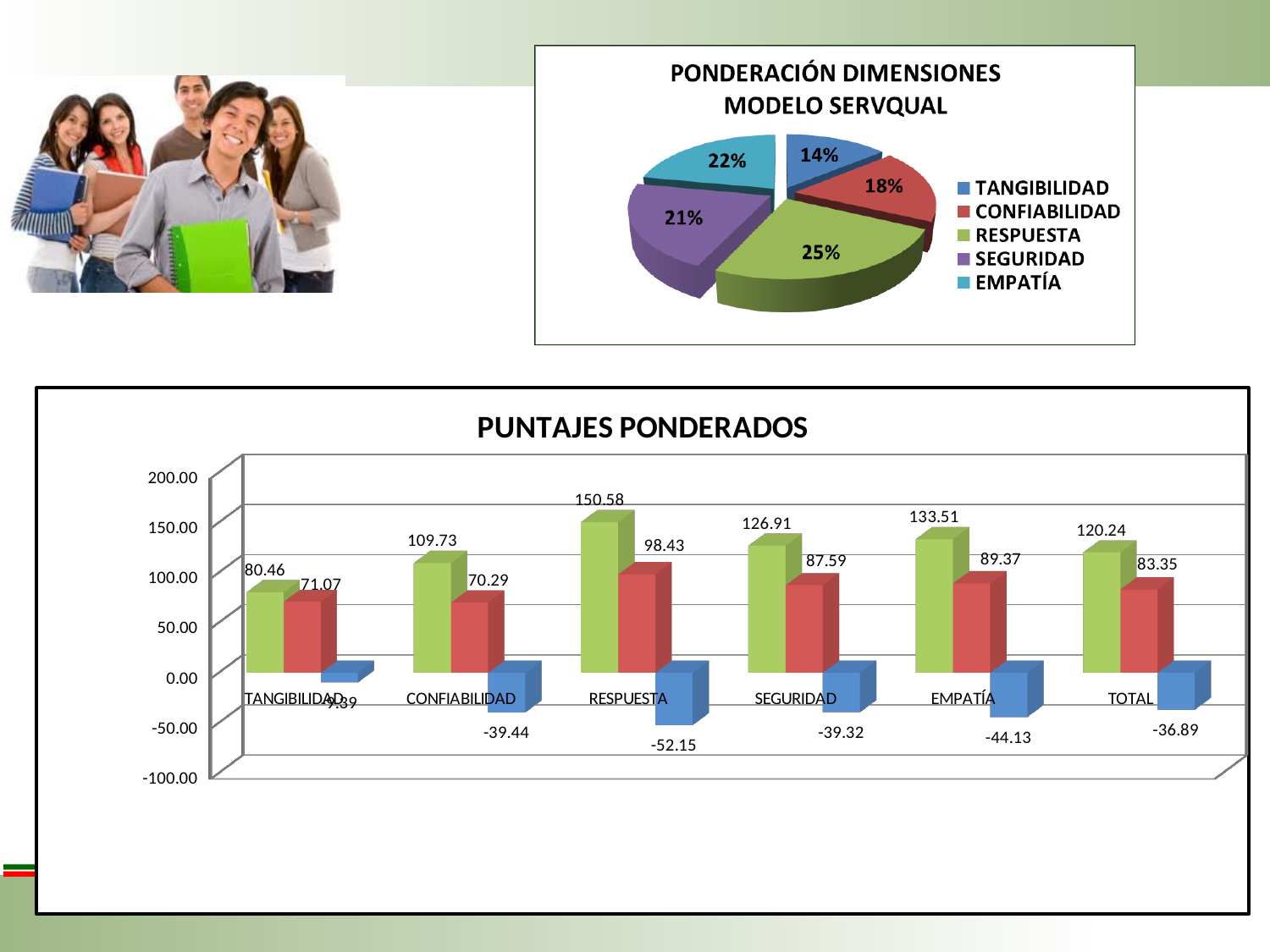
In the bar chart titled PUNTAJES PONDERADOS, which category has the lowest blue bar value? RESPUESTA What kind of chart is PUNTAJES PONDERADOS? Bar chart In the bar chart titled PUNTAJES PONDERADOS, what is the value of the red bar for SEGURIDAD? 87.59 In the pie chart titled PONDERACIÓN DIMENSIONES MODELO SERVQUAL, what share does CONFIABILIDAD have? 18% In the bar chart titled PUNTAJES PONDERADOS, which category has the highest green bar? RESPUESTA In the pie chart titled PONDERACIÓN DIMENSIONES MODELO SERVQUAL, what is the difference between the shares of EMPATÍA and SEGURIDAD? 1% In the pie chart titled PONDERACIÓN DIMENSIONES MODELO SERVQUAL, how many slices are there? 5 In the bar chart titled PUNTAJES PONDERADOS, what is the difference between the green bar and the red bar for TOTAL? 36.89 In the bar chart titled PUNTAJES PONDERADOS, what is the value of the blue bar for EMPATÍA? -44.13 In the pie chart titled PONDERACIÓN DIMENSIONES MODELO SERVQUAL, what share does RESPUESTA have? 25% In the bar chart titled PUNTAJES PONDERADOS, what is the value of the green bar for RESPUESTA? 150.58 In the pie chart titled PONDERACIÓN DIMENSIONES MODELO SERVQUAL, which dimension has the smallest share? TANGIBILIDAD